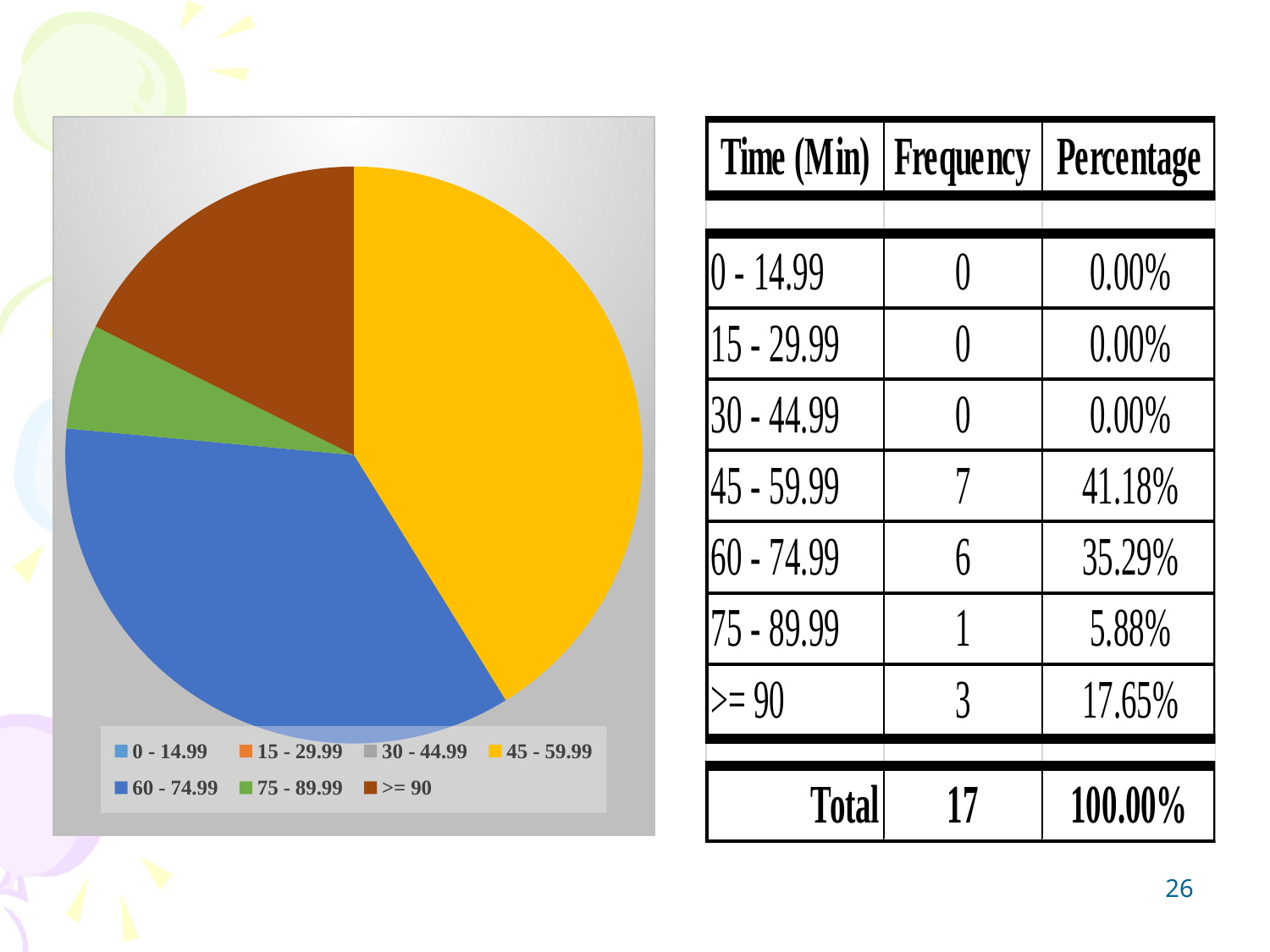
How many categories does the pie chart's legend list? 7 Which time category has the largest slice of the pie chart? 45 - 59.99 What kind of chart is shown on the left of the slide? pie chart Which time category with a visible slice has the smallest share of the pie chart? 75 - 89.99 According to the table, what percentage share does the 45 - 59.99 category have? 41.18% According to the table, what is the total frequency across all categories? 17 According to the table, what is the frequency for the 60 - 74.99 category? 6 According to the table, what percentage share does the >= 90 category have? 17.65% Which slice is larger in the pie chart, 60 - 74.99 or >= 90? 60 - 74.99 Which slice is larger in the pie chart, >= 90 or 75 - 89.99? >= 90 What is the difference in frequency between the 45 - 59.99 and 60 - 74.99 categories in the table? 1 What colour is the slice for the 45 - 59.99 category in the pie chart? yellow